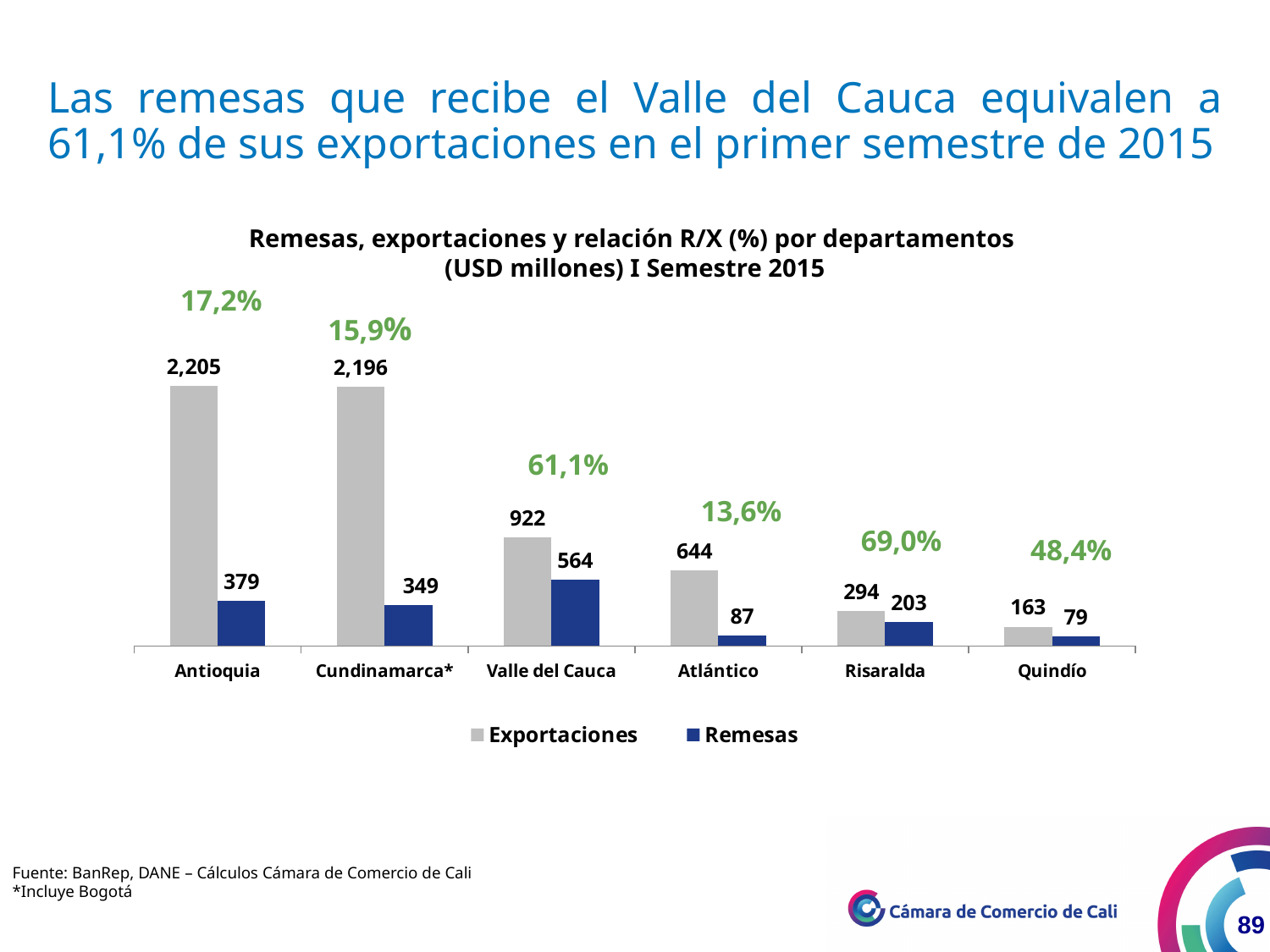
Do the Exportaciones values rise or fall from Antioquia to Quindío along the x axis? Fall What is the Exportaciones value for Valle del Cauca? 922 Which department has the highest Exportaciones value? Antioquia How many departments are shown on the x axis? 6 What is the difference between Exportaciones and Remesas for Valle del Cauca? 358 What R/X percentage is shown above Risaralda? 69,0% Which department has the lowest Remesas value? Quindío What kind of chart is shown on the slide? Bar chart Which series is shown in dark blue in the legend? Remesas Which is larger, the Remesas value for Antioquia or the Remesas value for Cundinamarca*? Antioquia How many series does the legend list? 2 What is the Remesas value for Atlántico? 87